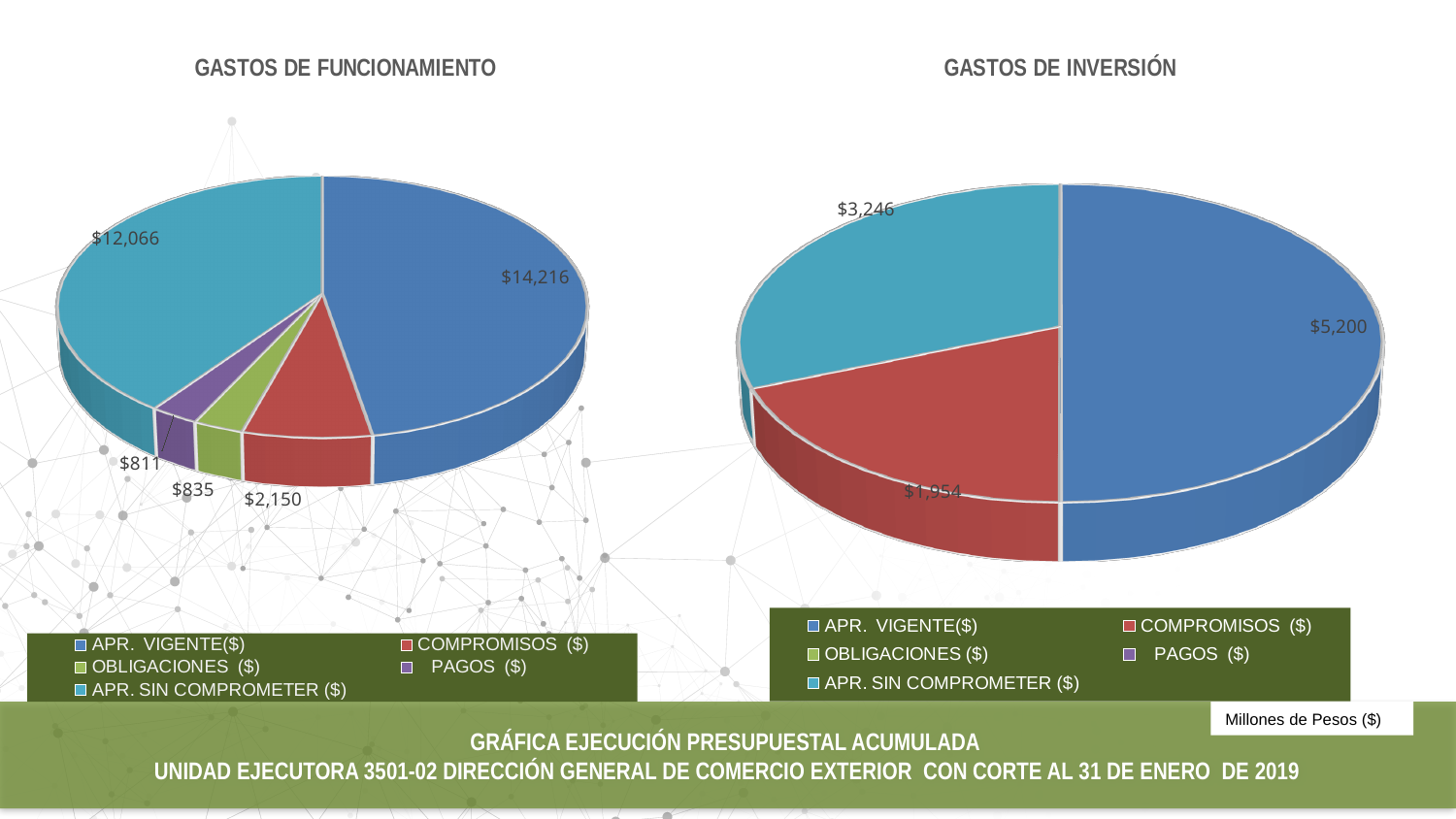
In the GASTOS DE INVERSIÓN chart, what is the value for COMPROMISOS ($)? $1,954 In the GASTOS DE FUNCIONAMIENTO chart, which is larger, OBLIGACIONES ($) or PAGOS ($)? OBLIGACIONES ($) In the GASTOS DE FUNCIONAMIENTO chart, what is the difference between APR. VIGENTE ($) and APR. SIN COMPROMETER ($)? $2,150 In the GASTOS DE FUNCIONAMIENTO chart, what is the value for APR. VIGENTE ($)? $14,216 In the GASTOS DE INVERSIÓN chart, what is the value for APR. SIN COMPROMETER ($)? $3,246 In the GASTOS DE FUNCIONAMIENTO chart, what is the value for COMPROMISOS ($)? $2,150 How many entries does the legend of the GASTOS DE FUNCIONAMIENTO chart list? 5 In the GASTOS DE INVERSIÓN chart, what is the difference between APR. VIGENTE ($) and COMPROMISOS ($)? $3,246 In the GASTOS DE FUNCIONAMIENTO chart, which category has the largest slice? APR. VIGENTE ($) In the GASTOS DE FUNCIONAMIENTO chart, what is the value for PAGOS ($)? $811 What kind of chart is the GASTOS DE INVERSIÓN chart? Pie chart In the GASTOS DE FUNCIONAMIENTO chart, which category has the smallest slice? PAGOS ($)